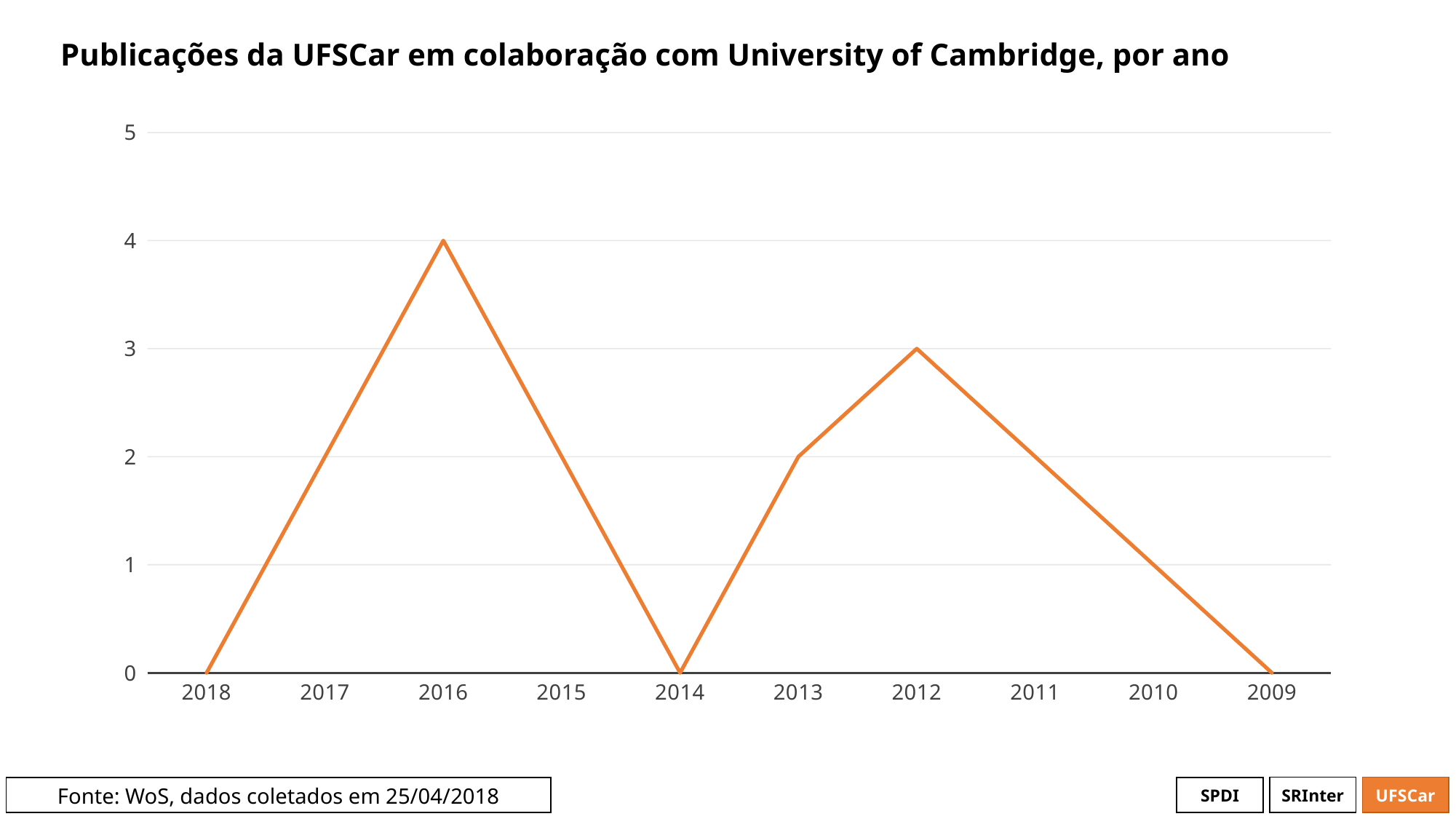
What is the title of the chart? Publicações da UFSCar em colaboração com University of Cambridge, por ano How many years are shown on the x axis? 10 What is the value for 2012? 3 What is the value for 2014? 0 What is the value for 2018? 0 What kind of chart is shown on the slide? line chart Do the values rise or fall from 2012 to 2009 along the x axis? fall What is the value for 2016? 4 What is the value for 2013? 2 Which is larger, the value for 2016 or the value for 2013? 2016 What is the difference between the values for 2016 and 2012? 1 Which year has the highest number of publications? 2016